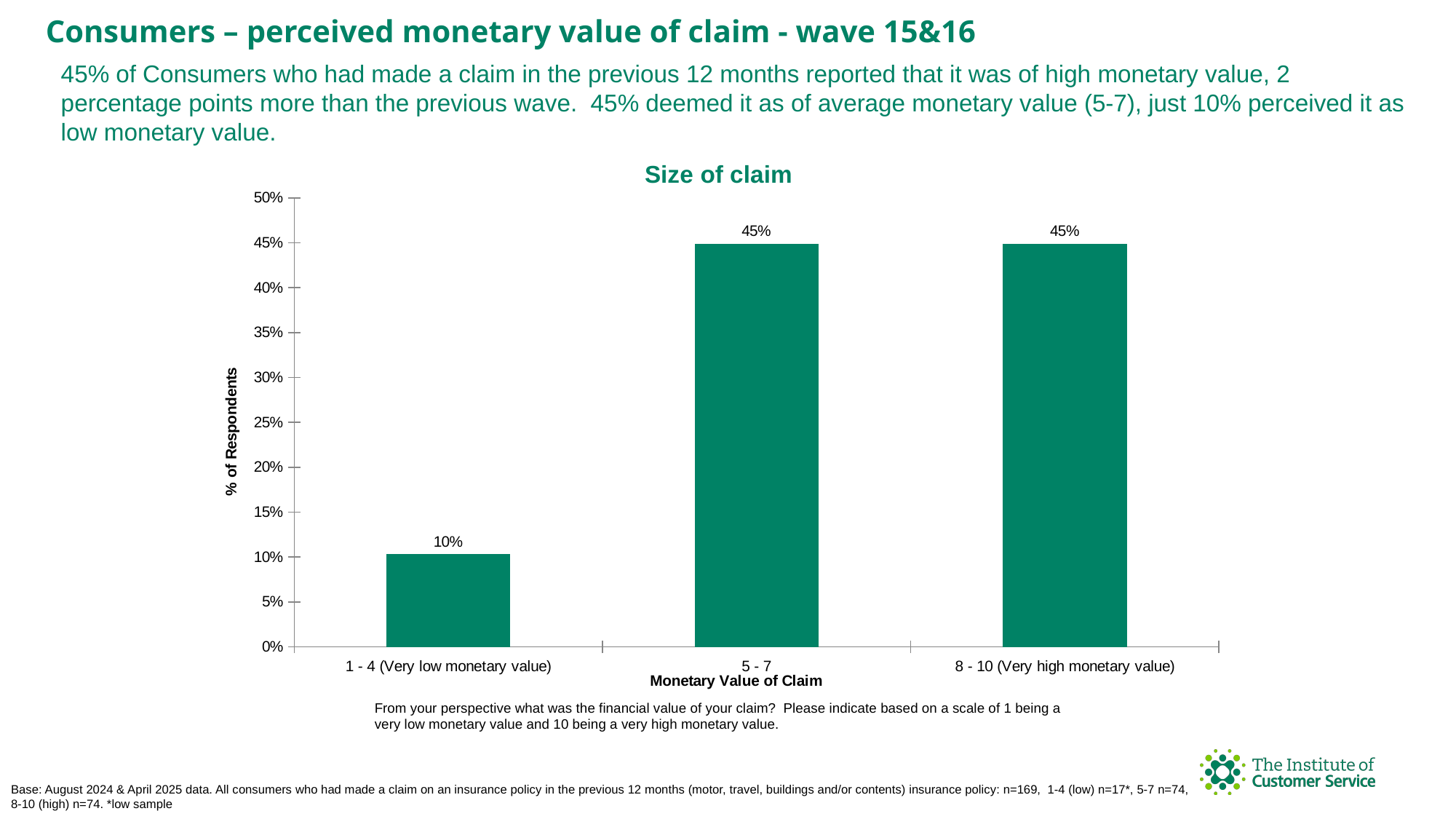
What type of chart is shown on the slide? Bar chart Which is larger: the value for 8 - 10 (Very high monetary value) or the value for 1 - 4 (Very low monetary value)? 8 - 10 (Very high monetary value) What is the difference in percentage points between the 5 - 7 category and the 1 - 4 (Very low monetary value) category? 35 percentage points What percentage of respondents rated their claim as 8 - 10 (Very high monetary value)? 45% What is the title of the chart? Size of claim What percentage of respondents rated their claim as 5 - 7? 45% Which category has the lowest percentage of respondents? 1 - 4 (Very low monetary value) Is the value for 1 - 4 (Very low monetary value) greater or less than 15%? less What is the label of the y axis of the chart? % of Respondents What percentage of respondents rated their claim as 1 - 4 (Very low monetary value)? 10% Is the value for 5 - 7 greater or less than 40%? greater How many categories are shown on the x axis of the chart? 3